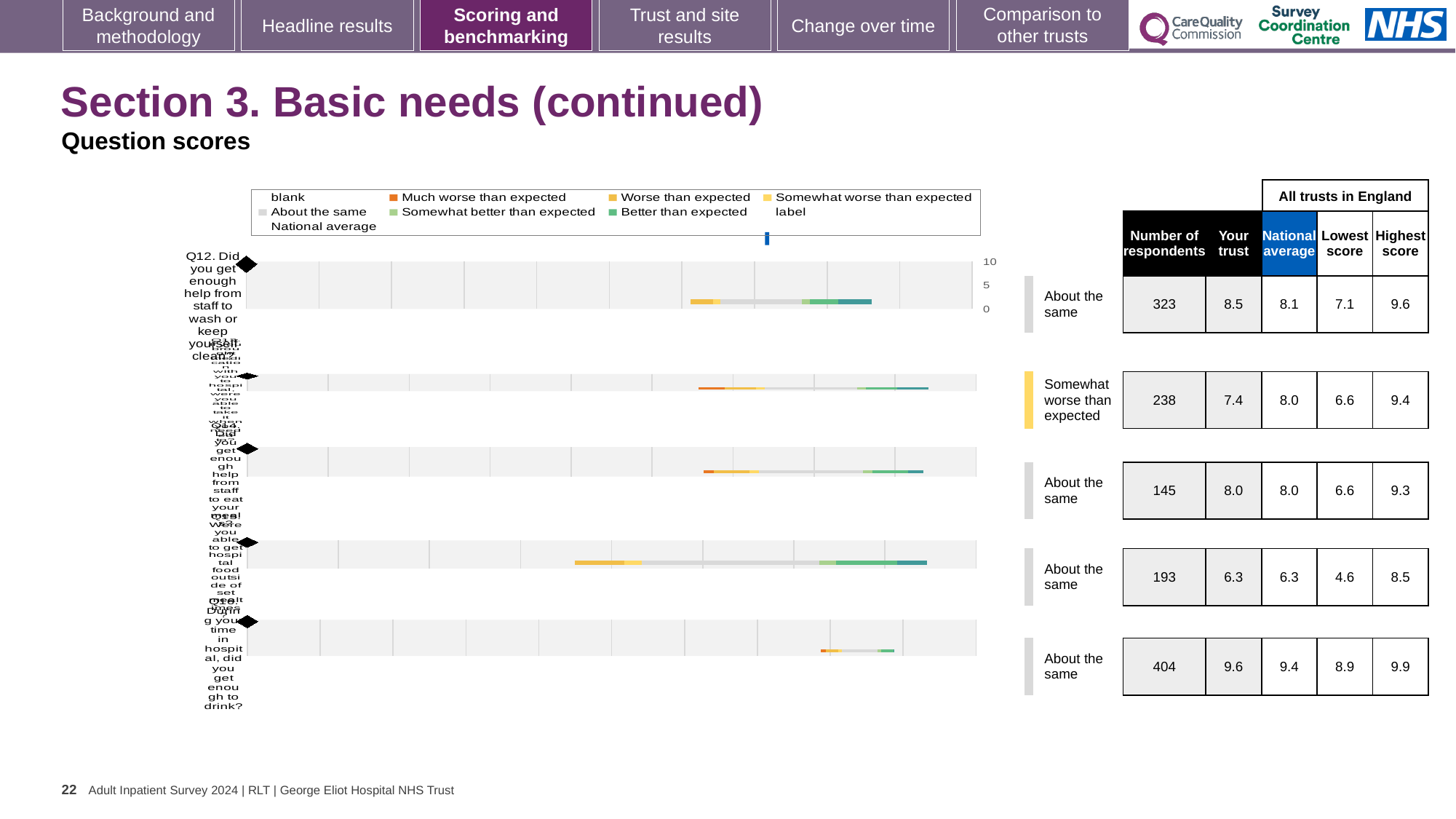
Which benchmark category is the second question row rated as? Somewhat worse than expected How many respondents answered Q16 (did you get enough to drink?), the last row of the chart? 404 Which has the higher 'Your trust' score: Q12 (help to wash or keep clean) or Q14 (help to eat your meals)? Q12 Which question row has the highest 'Your trust' score? Q16 (did you get enough to drink?), 9.6 What kind of chart is used to show the question scores? Bar chart What is the highest score across all trusts in England for Q16 (did you get enough to drink?)? 9.9 By how much does the trust's score for Q12 exceed the national average for that question? 0.4 What is the difference between the highest and lowest scores for Q16 (did you get enough to drink?)? 1.0 What is the 'Your trust' score for Q12 (help from staff to wash or keep yourself clean), the first row of the chart? 8.5 How many question rows are plotted in the chart? 5 Which question row has the lowest 'Your trust' score? The fourth row, 6.3 What is the national average score for Q14 (help from staff to eat your meals), the third row? 8.0